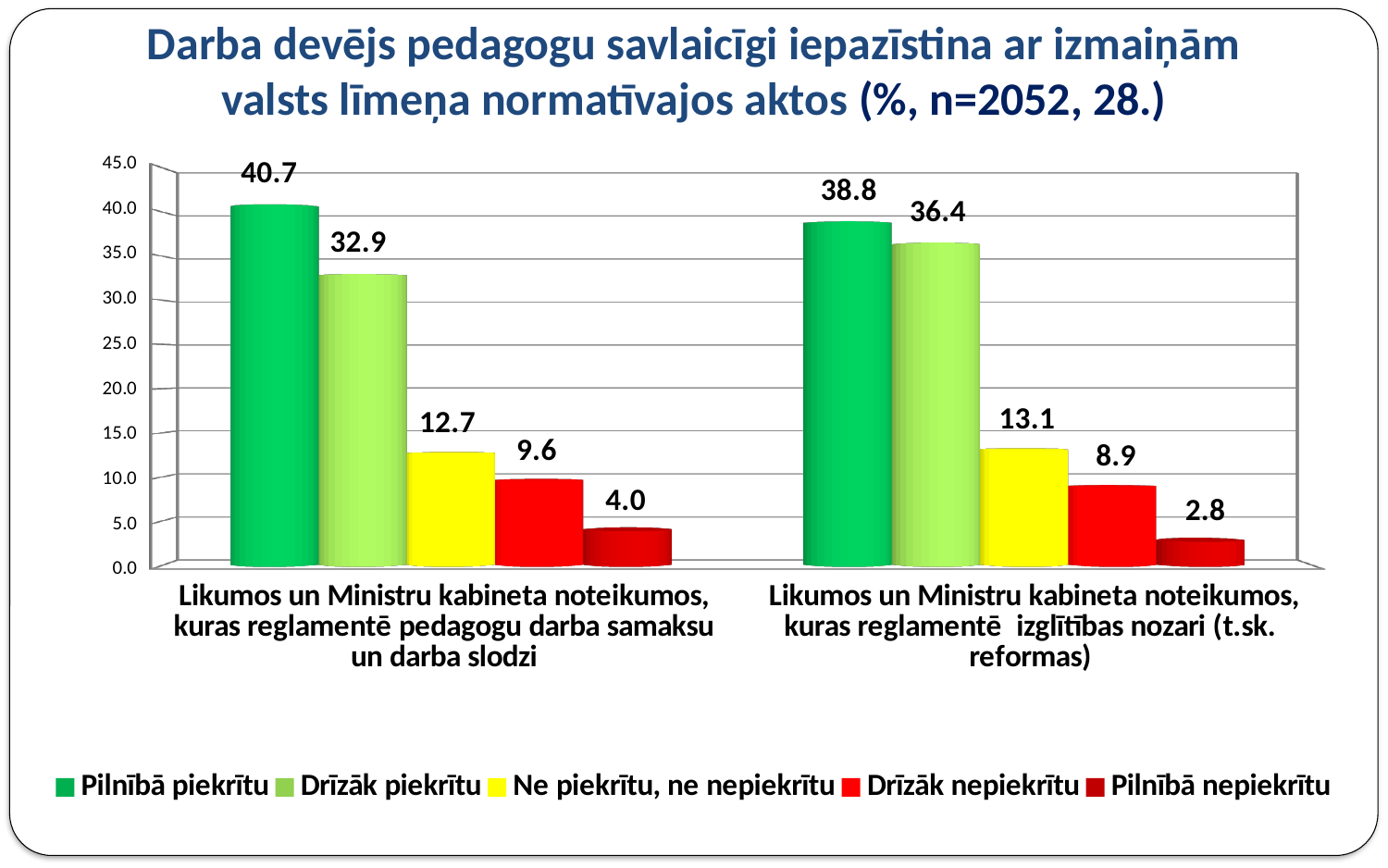
Which series has the lowest value in the category "Likumos un Ministru kabineta noteikumos, kuras reglamentē izglītības nozari (t.sk. reformas)"? Pilnībā nepiekrītu What is the value for "Pilnībā nepiekrītu" in the category "Likumos un Ministru kabineta noteikumos, kuras reglamentē izglītības nozari (t.sk. reformas)"? 2.8 How many series does the legend list? 5 What is the value for "Pilnībā piekrītu" in the category "Likumos un Ministru kabineta noteikumos, kuras reglamentē pedagogu darba samaksu un darba slodzi"? 40.7 How many categories are shown on the x axis? 2 Which series has the highest value in the category "Likumos un Ministru kabineta noteikumos, kuras reglamentē pedagogu darba samaksu un darba slodzi"? Pilnībā piekrītu Which category has the larger value for "Drīzāk piekrītu"? Likumos un Ministru kabineta noteikumos, kuras reglamentē izglītības nozari (t.sk. reformas) What is the value for "Drīzāk piekrītu" in the category "Likumos un Ministru kabineta noteikumos, kuras reglamentē izglītības nozari (t.sk. reformas)"? 36.4 What kind of chart is shown on the slide? bar chart What is the difference between the "Pilnībā piekrītu" values of the two categories? 1.9 Is the value for "Drīzāk nepiekrītu" in the category "Likumos un Ministru kabineta noteikumos, kuras reglamentē pedagogu darba samaksu un darba slodzi" greater or less than 10.0? less What is the difference between "Ne piekrītu, ne nepiekrītu" and "Drīzāk nepiekrītu" in the category "Likumos un Ministru kabineta noteikumos, kuras reglamentē izglītības nozari (t.sk. reformas)"? 4.2